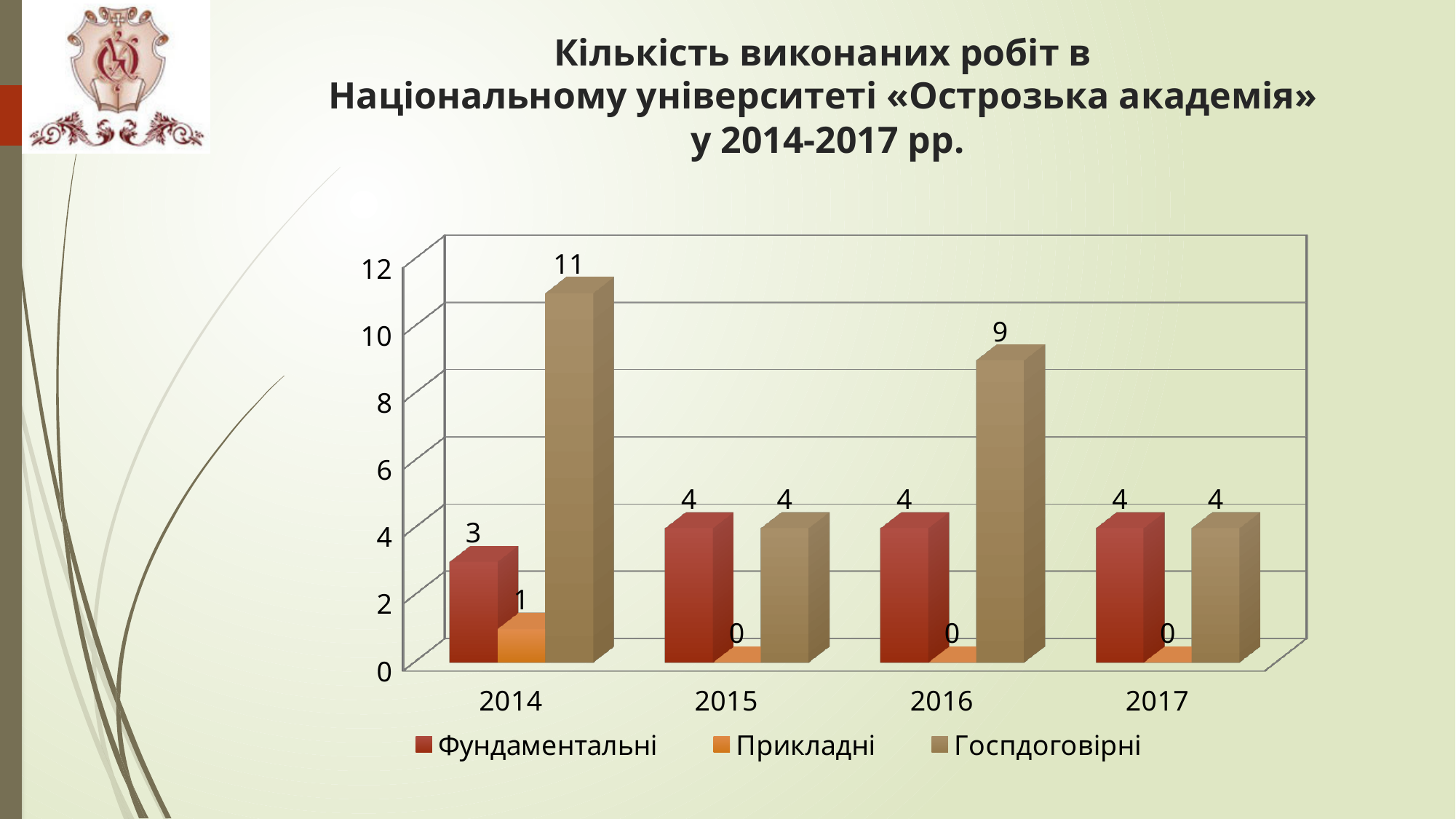
How many series does the legend list? 3 What is the value for Госпдоговірні in 2014? 11 What is the value for Госпдоговірні in 2016? 9 What is the value for Прикладні in 2015? 0 How many years are shown on the x axis? 4 In which year is the value for Госпдоговірні highest? 2014 In which year is the value for Фундаментальні lowest? 2014 What is the difference between Госпдоговірні and Фундаментальні in 2014? 8 What is the value for Фундаментальні in 2014? 3 What kind of chart is shown on the slide? Bar chart Which series is shown in orange in the legend? Прикладні Which is larger in 2016: Госпдоговірні or Фундаментальні? Госпдоговірні